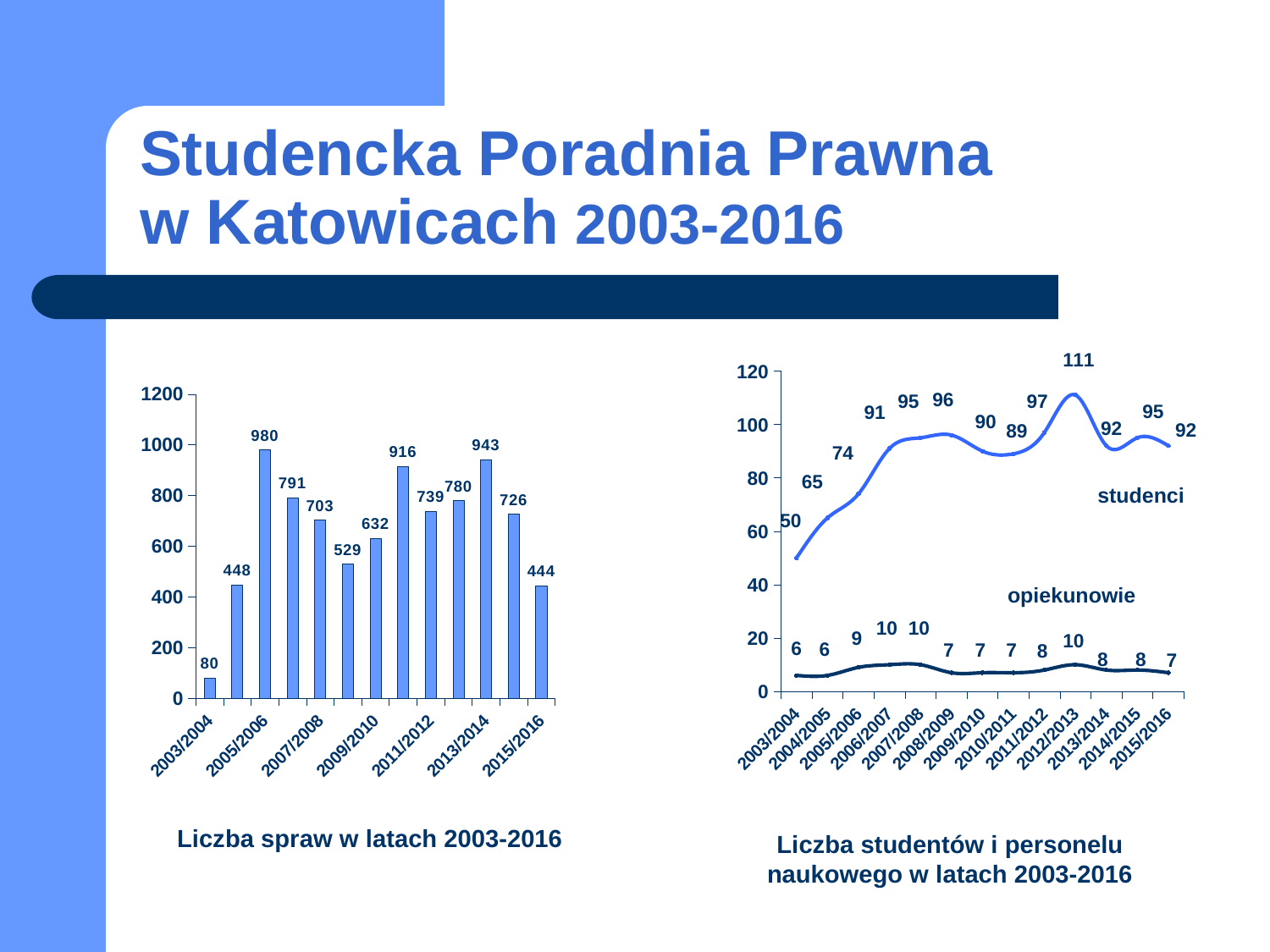
In the chart titled 'Liczba spraw w latach 2003-2016', which year has the lowest value? 2003/2004 How many series are plotted in the chart titled 'Liczba studentów i personelu naukowego w latach 2003-2016'? 2 In the chart titled 'Liczba spraw w latach 2003-2016', what is the value for 2015/2016? 444 What kind of chart is the one on the left of the slide? Bar chart In the chart titled 'Liczba studentów i personelu naukowego w latach 2003-2016', what is the difference between studenci and opiekunowie in 2003/2004? 44 In the chart titled 'Liczba spraw w latach 2003-2016', what is the value for 2005/2006? 980 In the chart titled 'Liczba studentów i personelu naukowego w latach 2003-2016', what is the value for studenci in 2012/2013? 111 In the chart titled 'Liczba spraw w latach 2003-2016', what is the difference between the values for 2013/2014 and 2015/2016? 499 In the chart titled 'Liczba spraw w latach 2003-2016', how many bars are plotted? 13 In the chart titled 'Liczba studentów i personelu naukowego w latach 2003-2016', what is the value for opiekunowie in 2005/2006? 9 In the chart titled 'Liczba studentów i personelu naukowego w latach 2003-2016', which year has the highest value for studenci? 2012/2013 In the chart titled 'Liczba spraw w latach 2003-2016', which year has the highest value? 2005/2006